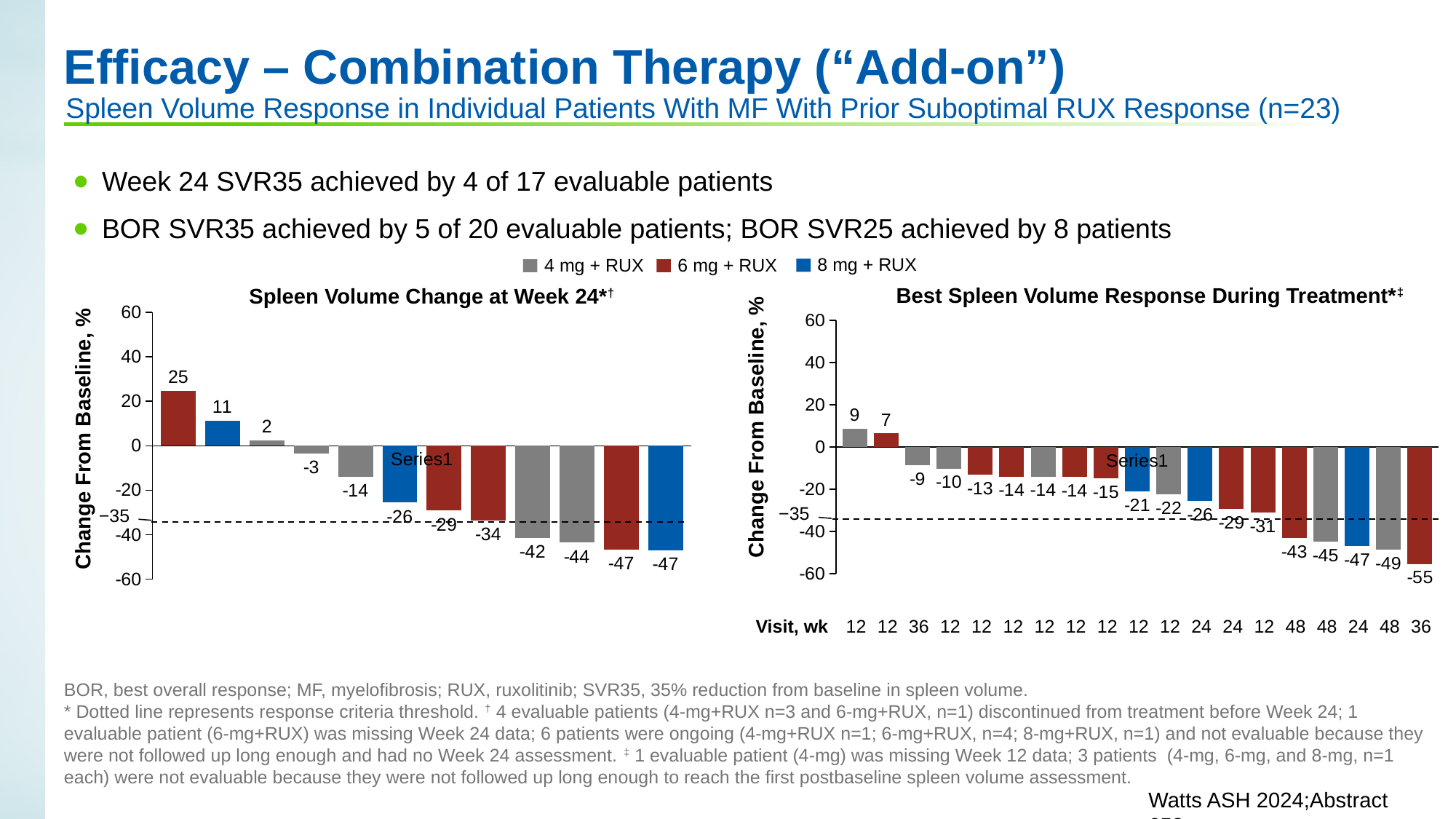
In the "Spleen Volume Change at Week 24" chart, what is the lowest value shown? -47 At what value is the dotted response-threshold line drawn on both charts? -35 Do the bar values rise or fall from left to right in the "Best Spleen Volume Response During Treatment" chart? fall How many bars are plotted in the "Best Spleen Volume Response During Treatment" chart? 19 How many bars are plotted in the "Spleen Volume Change at Week 24" chart? 12 In the "Spleen Volume Change at Week 24" chart, what is the difference between the highest value (25) and the lowest value (-47)? 72 What kind of chart is the "Spleen Volume Change at Week 24" chart? bar chart In the "Best Spleen Volume Response During Treatment" chart, what is the lowest value shown? -55 How many series does the shared legend list? 3 In the "Best Spleen Volume Response During Treatment" chart, what is the highest value shown? 9 In the "Best Spleen Volume Response During Treatment" chart, which is larger: the first bar (9) or the second bar (7)? the first bar (9) In the "Spleen Volume Change at Week 24" chart, what is the highest value shown? 25